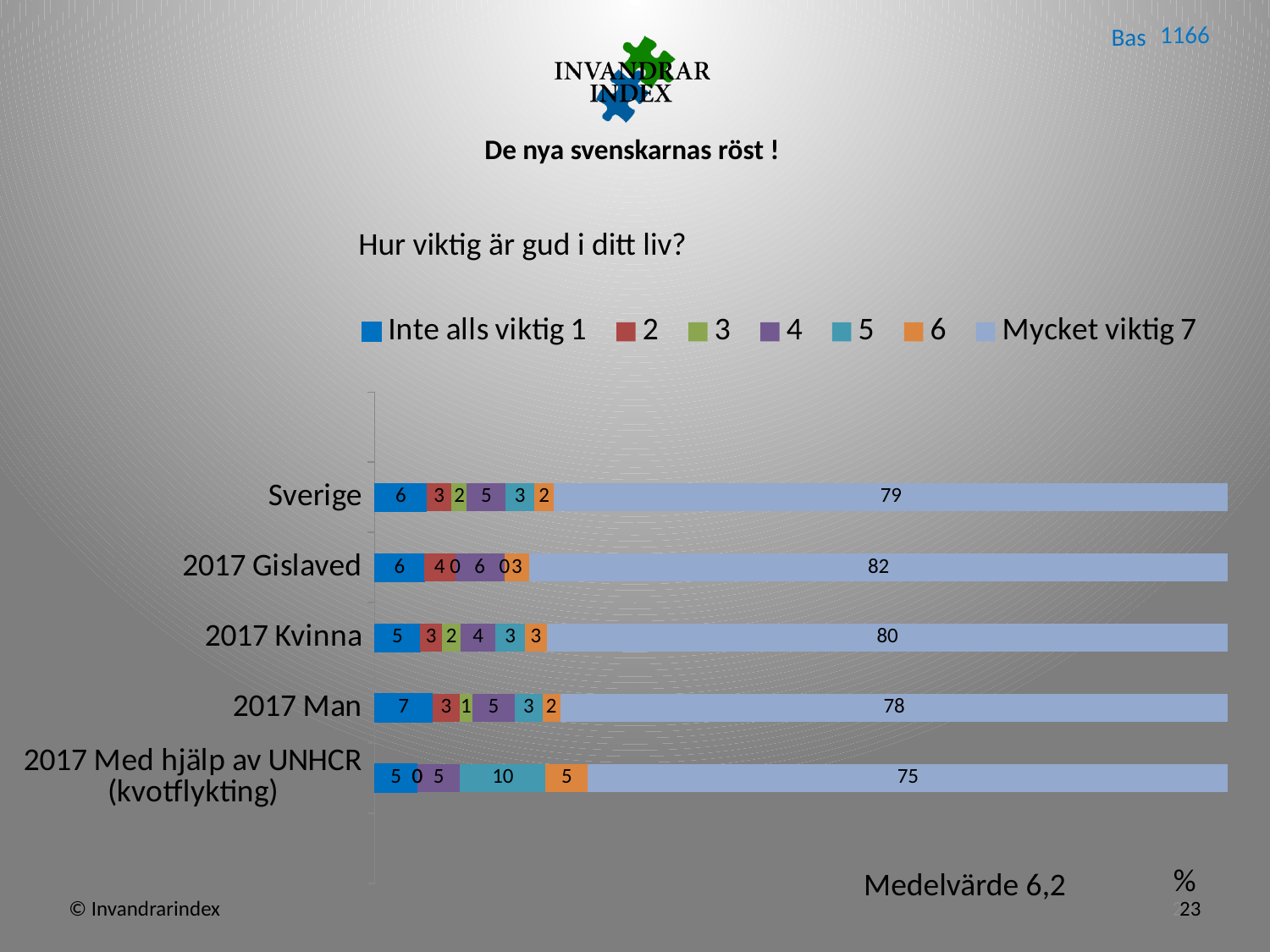
What is the value of series '5' for 2017 Med hjälp av UNHCR (kvotflykting)? 10 How many categories are plotted on the chart? 5 Which has the larger 'Mycket viktig 7' value, 2017 Kvinna or 2017 Man? 2017 Kvinna What is the value of 'Mycket viktig 7' for Sverige? 79 What is the value of 'Mycket viktig 7' for 2017 Gislaved? 82 What is the value of 'Inte alls viktig 1' for 2017 Man? 7 How many series does the legend list? 7 What is the difference between the 'Mycket viktig 7' values for 2017 Gislaved and 2017 Man? 4 What kind of chart is shown on the slide? Stacked bar chart What is the question shown as the chart title? Hur viktig är gud i ditt liv? Which category has the highest value for 'Mycket viktig 7'? 2017 Gislaved Which category has the lowest value for 'Mycket viktig 7'? 2017 Med hjälp av UNHCR (kvotflykting)